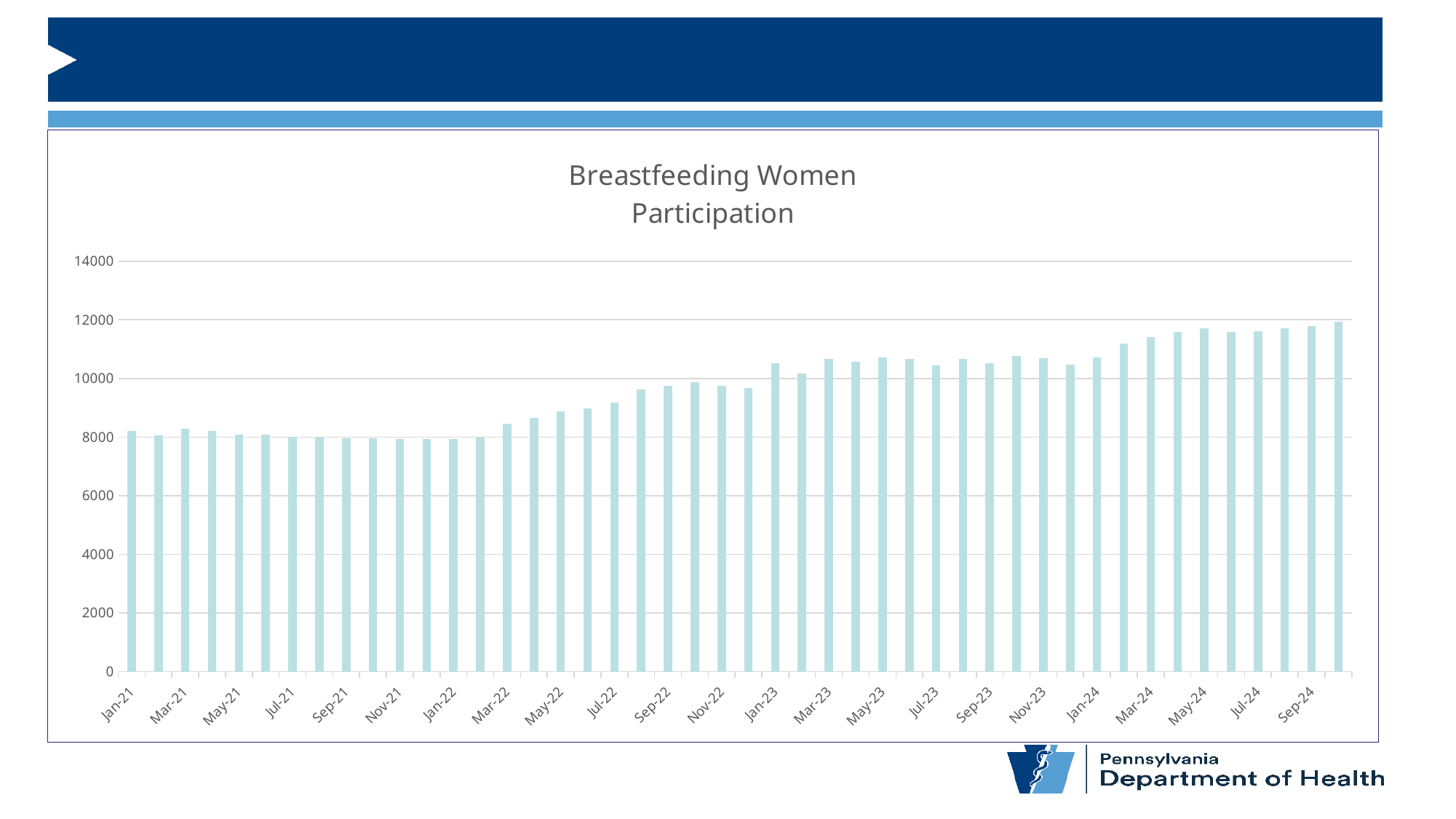
What is the title of the chart? Breastfeeding Women Participation Which is larger, the value for Mar-22 or the value for Mar-23? Mar-23 Is the value for Sep-24 greater or less than 10000? greater Is the value for Jan-21 greater or less than 10000? less Is the value for Mar-24 greater or less than 10000? greater What kind of chart is shown on the slide? bar chart Do the values generally rise or fall from Jan-21 to Sep-24? rise How many bars are plotted in the chart? 46 Which is larger, the value for Jan-21 or the value for Sep-24? Sep-24